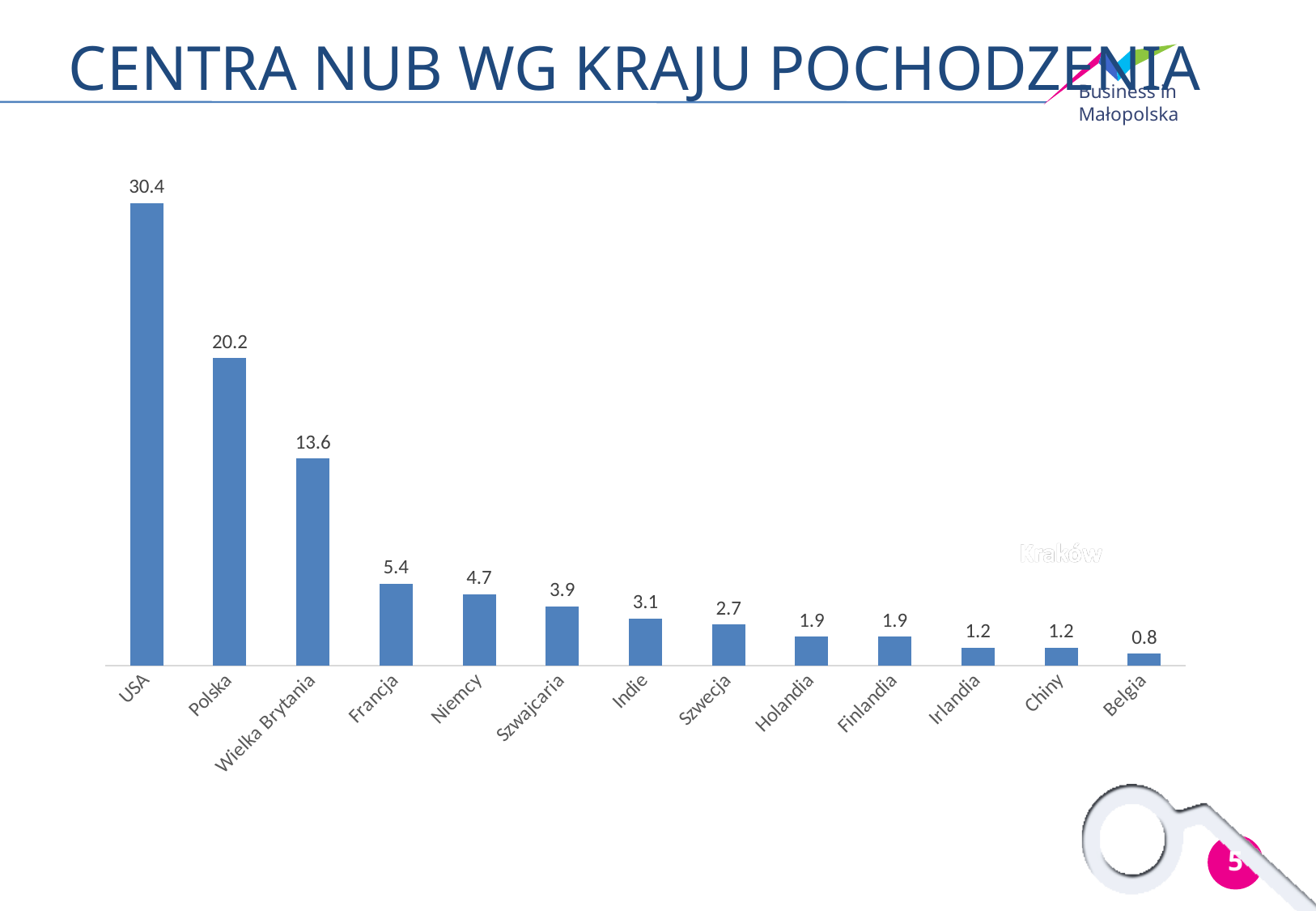
What is the value for USA? 30.4 What is the difference between the values for USA and Polska? 10.2 Which country has the lowest value? Belgia Which country has the highest value? USA Do the values rise or fall from left to right along the x axis? Fall What is the value for Szwajcaria? 3.9 What is the difference between the values for Francja and Niemcy? 0.7 Which is larger, the value for Indie or the value for Szwecja? Indie What is the title of the slide? CENTRA NUB WG KRAJU POCHODZENIA What kind of chart is shown on the slide? Bar chart What is the value for Wielka Brytania? 13.6 How many countries are shown on the chart? 13